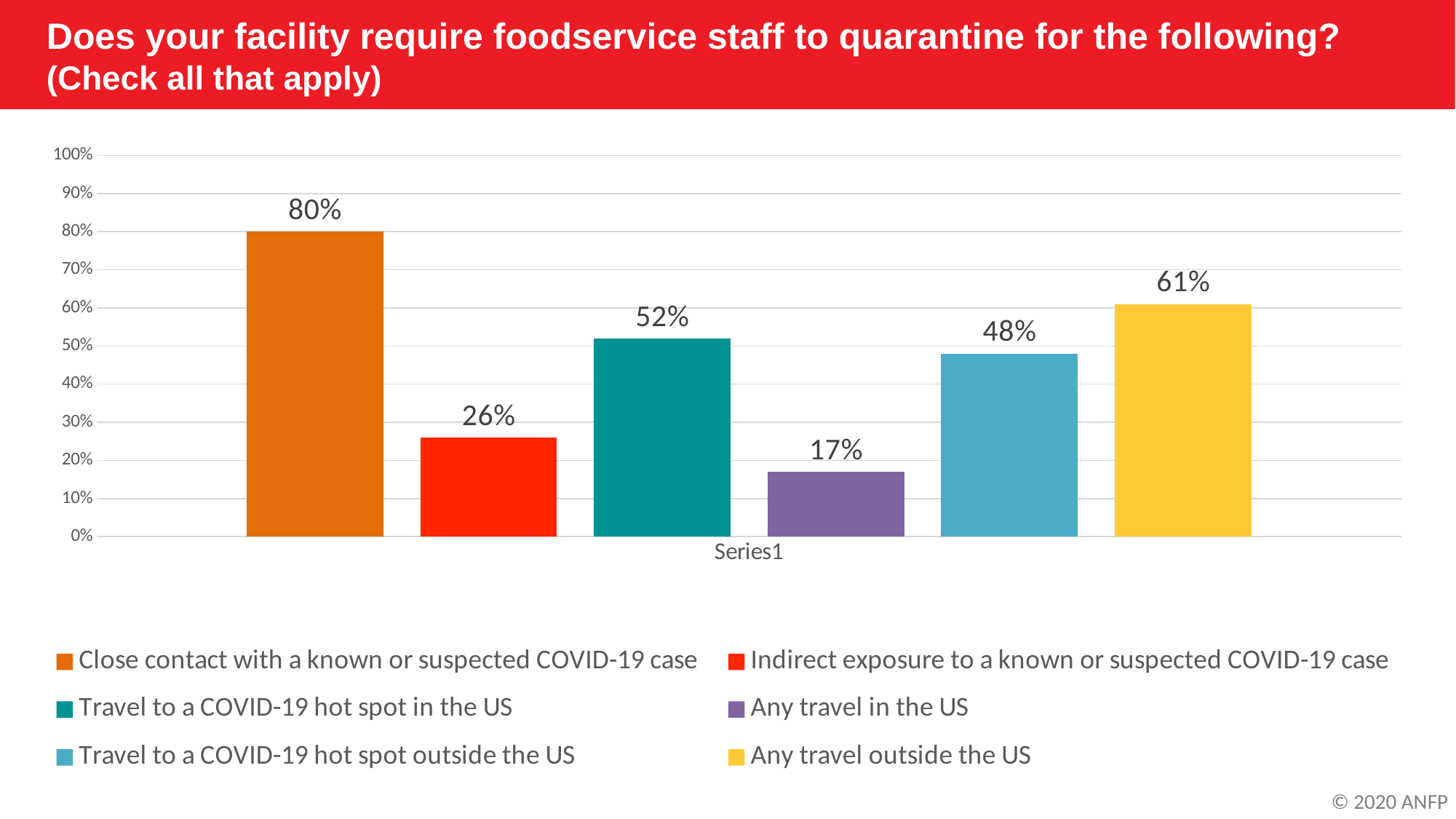
What colour is the bar for any travel outside the US? Yellow Which category has the highest value? Close contact with a known or suspected COVID-19 case What is the value for travel to a COVID-19 hot spot outside the US? 48% What kind of chart is shown on the slide? Bar chart How many bars are plotted on the chart? 6 Is the value for indirect exposure to a known or suspected COVID-19 case greater or less than 30%? less Which is larger: the value for any travel outside the US or the value for travel to a COVID-19 hot spot in the US? Any travel outside the US Which category has the lowest value? Any travel in the US What percentage of facilities require quarantine for close contact with a known or suspected COVID-19 case? 80% What is the difference between the values for any travel outside the US and any travel in the US? 44% What is the difference between the values for travel to a COVID-19 hot spot in the US and indirect exposure to a known or suspected COVID-19 case? 26% What percentage of facilities require quarantine for any travel in the US? 17%